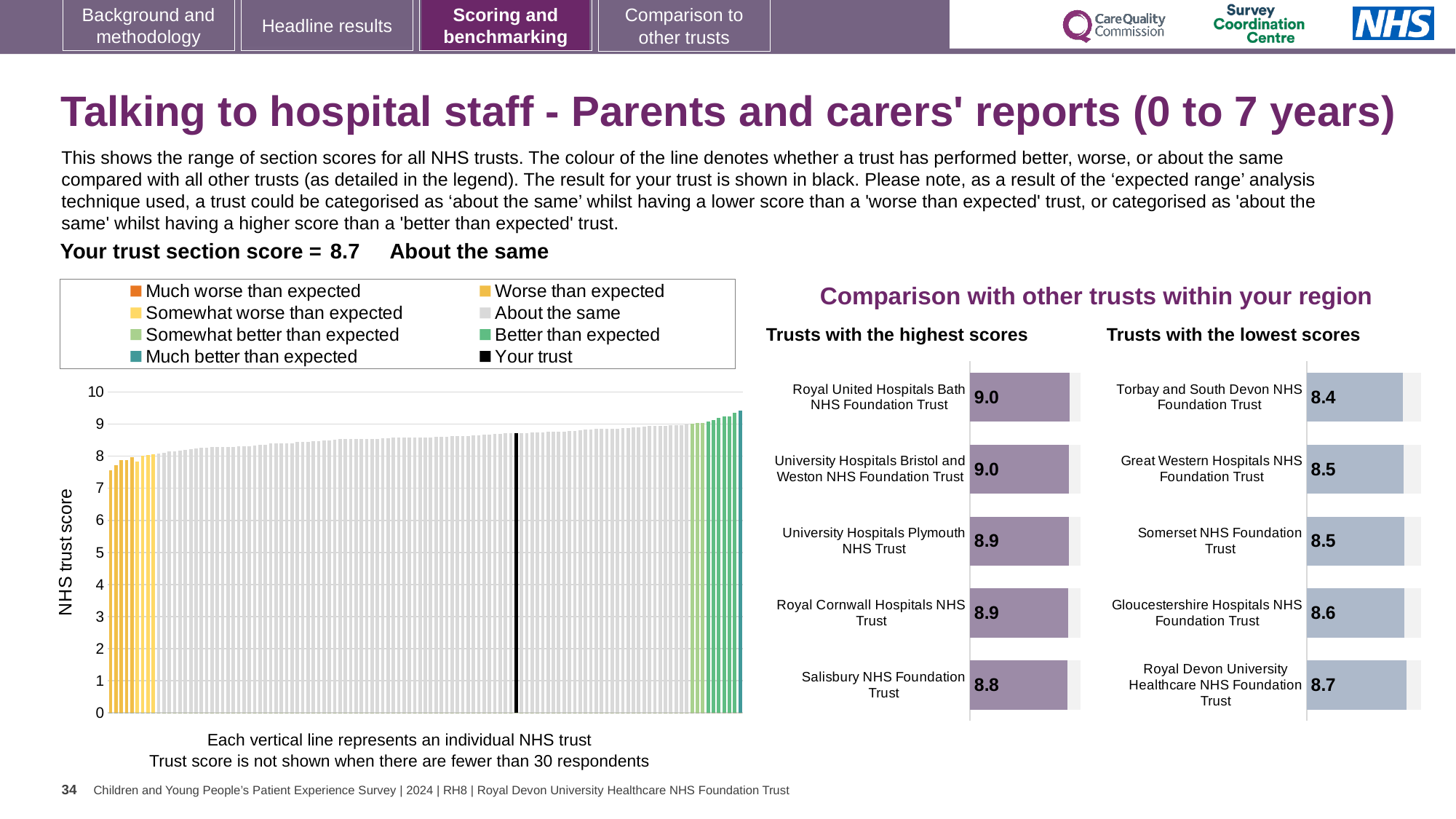
In the 'Trusts with the lowest scores' chart, what is the difference between the score for Royal Devon University Healthcare NHS Foundation Trust and the score for Torbay and South Devon NHS Foundation Trust? 0.3 In the 'Trusts with the lowest scores' chart, what is the score for Torbay and South Devon NHS Foundation Trust? 8.4 In the 'Trusts with the highest scores' chart, what is the difference between the score for Royal United Hospitals Bath NHS Foundation Trust and the score for Salisbury NHS Foundation Trust? 0.2 In the 'Trusts with the lowest scores' chart, what is the score for Gloucestershire Hospitals NHS Foundation Trust? 8.6 In the main NHS trust score chart on the left, is the value of the black bar representing your trust greater or less than 8? greater In the 'Trusts with the highest scores' chart, which has the larger score: University Hospitals Plymouth NHS Trust or Salisbury NHS Foundation Trust? University Hospitals Plymouth NHS Trust In the 'Trusts with the lowest scores' chart, which trust has the lowest score? Torbay and South Devon NHS Foundation Trust How many entries does the legend of the main NHS trust score chart list? 8 In the 'Trusts with the lowest scores' chart, which trust has the highest score? Royal Devon University Healthcare NHS Foundation Trust How many trusts are listed in the 'Trusts with the highest scores' chart? 5 In the 'Trusts with the highest scores' chart, what is the score for Salisbury NHS Foundation Trust? 8.8 In the main NHS trust score chart on the left, is the value of the leftmost (lowest) bar greater or less than 8? less